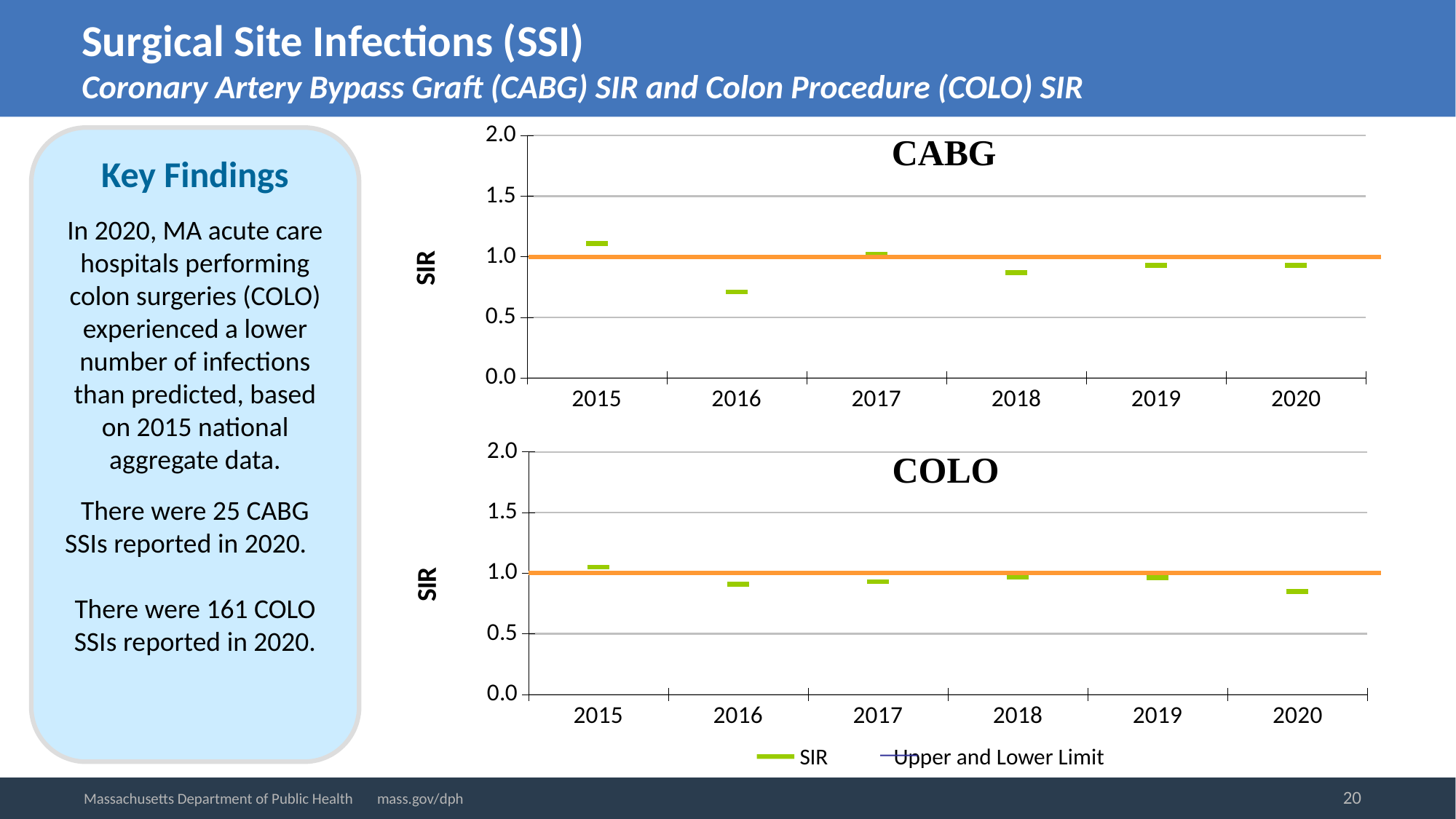
In the CABG chart, is the SIR for 2015 greater or less than 1.0? greater In the CABG chart, which year has the lowest SIR? 2016 In the CABG chart, which year has the highest SIR? 2015 In the CABG chart, is the SIR for 2016 greater or less than 1.0? less In the COLO chart, is the SIR for 2020 greater or less than 1.0? less In the COLO chart, which year has the larger SIR, 2015 or 2020? 2015 In the COLO chart, which year has the lowest SIR? 2020 In the COLO chart, which year has the highest SIR? 2015 What is the label on the y axis of the CABG chart? SIR How many years are shown on the x axis of the CABG chart? 6 How many series does the legend below the COLO chart list? 2